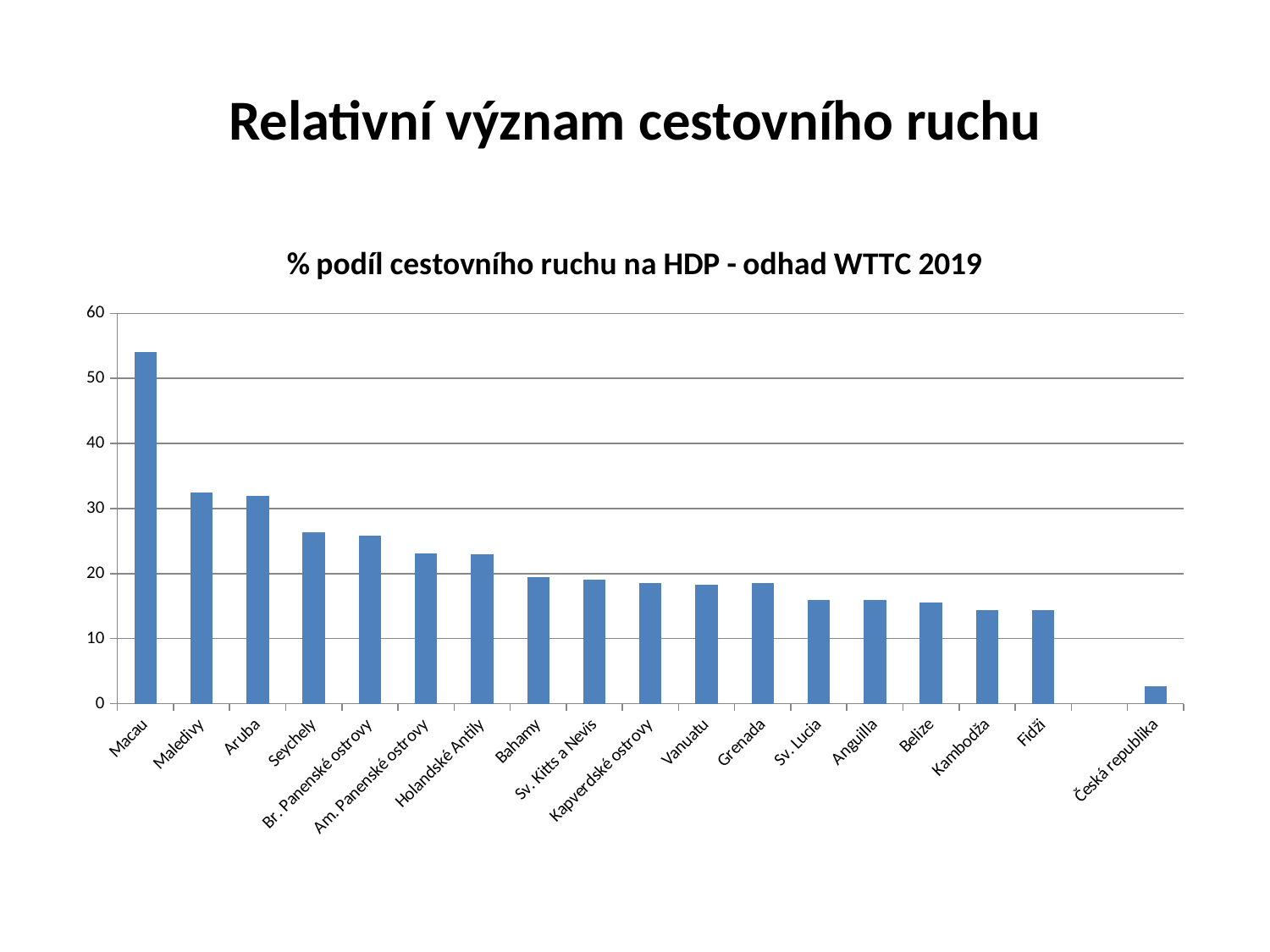
Which is larger, the value for Macau or the value for Maledivy? Macau Which category has the highest value? Macau Which is larger, the value for Seychely or the value for Fidži? Seychely What kind of chart is shown on the slide? bar chart Is the value for Česká republika greater or less than 10? less Is the value for Macau greater or less than 50? greater Is the value for Maledivy greater or less than 30? greater What is the title of the chart? % podíl cestovního ruchu na HDP - odhad WTTC 2019 Which category has the lowest value? Česká republika Do the values generally rise or fall from left to right along the x axis? fall